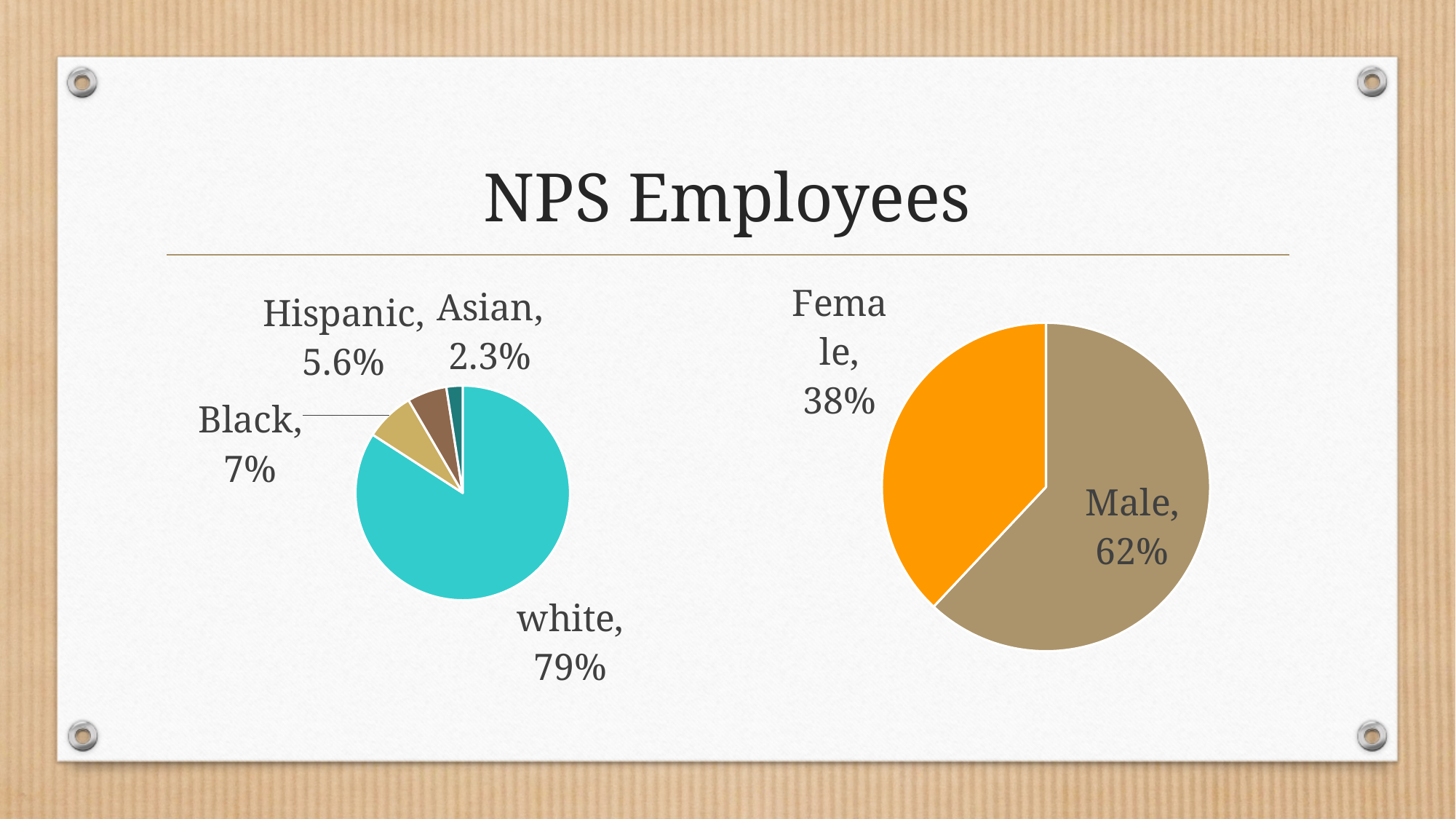
In the left pie chart, what percentage of NPS employees are Asian? 2.3% In the left pie chart, what percentage of NPS employees are white? 79% In the left pie chart, which is larger, the Black share or the Hispanic share? Black In the right pie chart, what percentage of NPS employees are Female? 38% In the left pie chart, how many slices are there? 4 In the left pie chart, what percentage of NPS employees are Black? 7% In the right pie chart, what is the difference between the Male and Female shares? 24% What type of chart is used on the right side of the slide? Pie chart In the left pie chart, what percentage of NPS employees are Hispanic? 5.6% In the left pie chart, which group has the largest share? white In the left pie chart, which group has the smallest share? Asian In the right pie chart, what percentage of NPS employees are Male? 62%